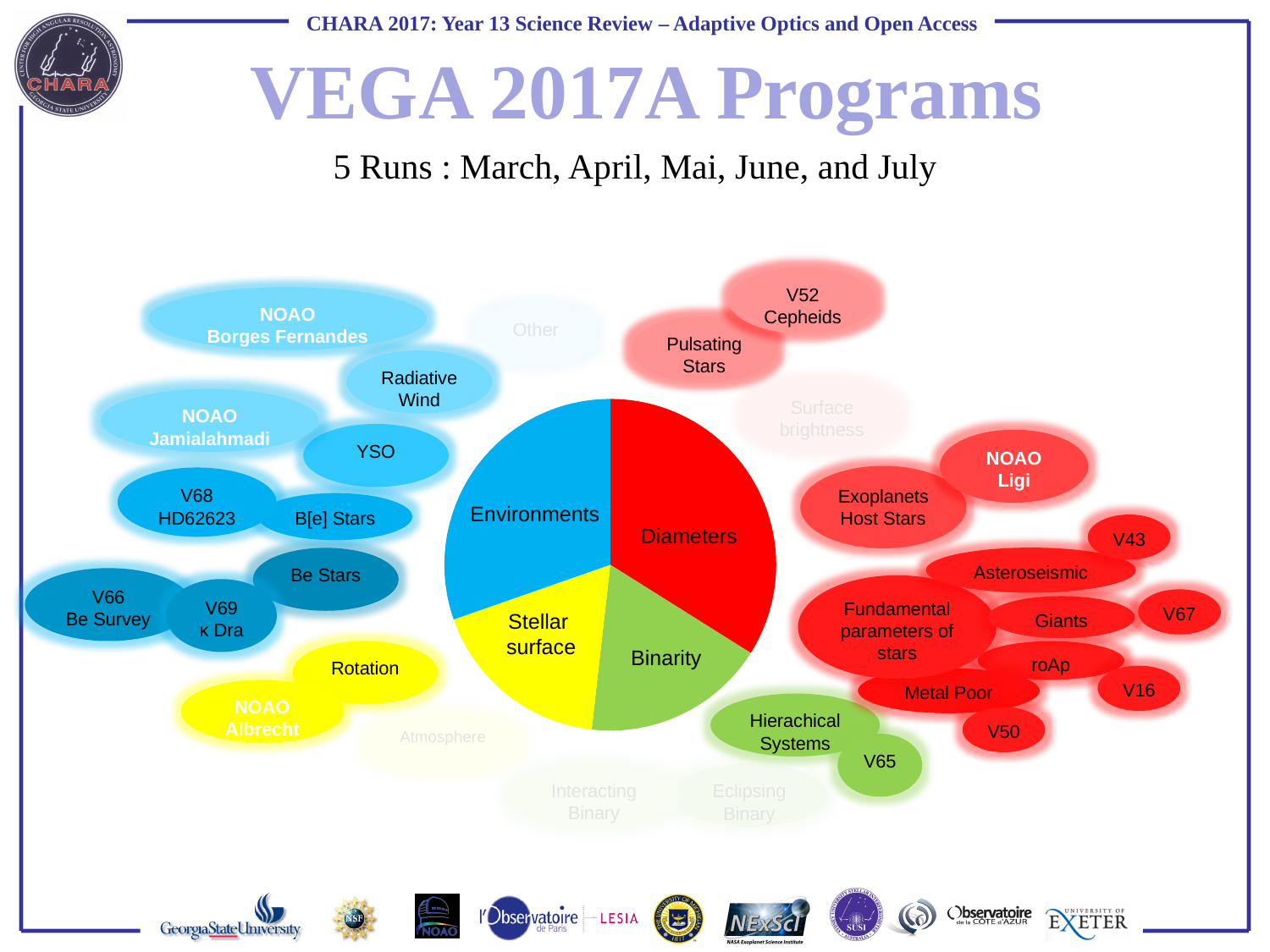
Which slice of the pie chart is coloured yellow? Stellar surface Which slice of the pie chart is coloured green? Binarity Which slice of the pie chart is coloured red? Diameters Which slice of the pie chart is coloured blue? Environments What kind of chart is shown in the centre of the slide? pie chart How many slices does the pie chart have? 4